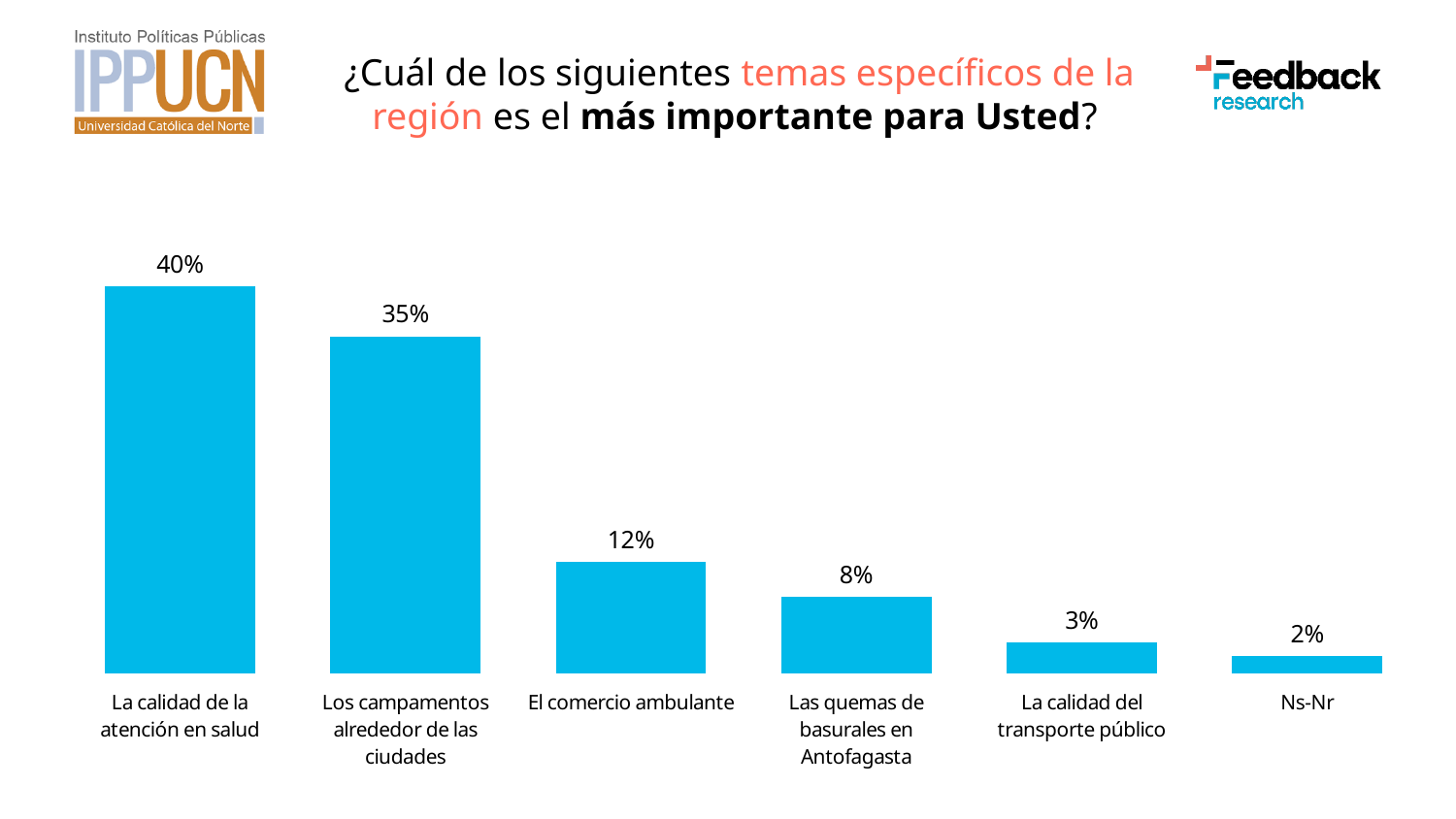
Do the values rise or fall from left to right across the categories? Fall Which category has the highest value? La calidad de la atención en salud What percentage is shown for 'Ns-Nr'? 2% What percentage is shown for 'El comercio ambulante'? 12% What is the difference between the values for 'La calidad de la atención en salud' and 'Los campamentos alrededor de las ciudades'? 5% What kind of chart is shown on the slide? Bar chart How many categories are shown in the chart? 6 Which is larger: the value for 'El comercio ambulante' or for 'La calidad del transporte público'? El comercio ambulante What is the value shown for 'Los campamentos alrededor de las ciudades'? 35% What is the value for 'Las quemas de basurales en Antofagasta'? 8% Which category has the lowest value? Ns-Nr What percentage of respondents chose 'La calidad de la atención en salud' as the most important topic? 40%